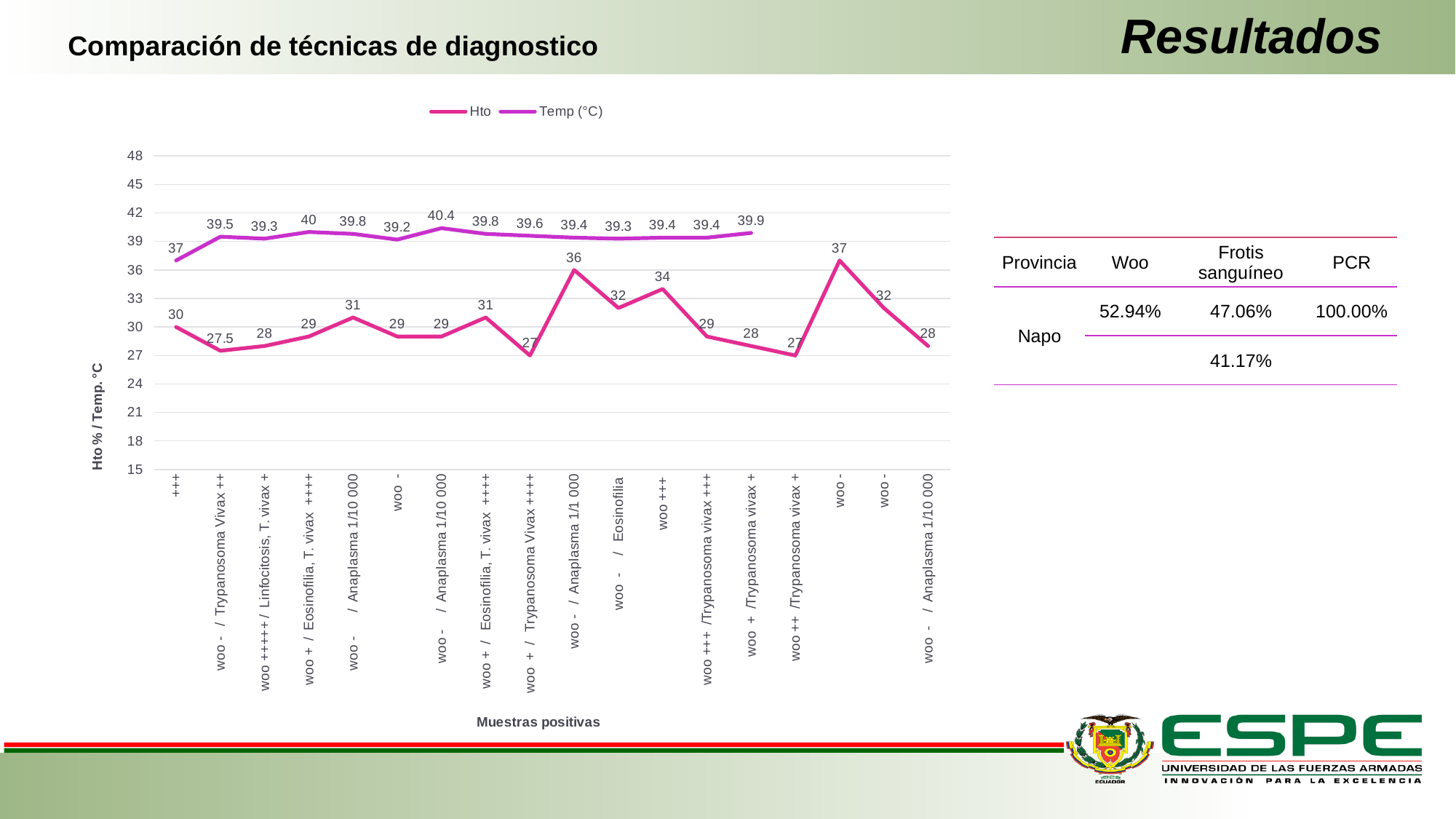
What is the Hto value for the category "woo +++"? 34 What kind of chart is shown on the slide? line chart What is the Hto value for the category "woo - / Anaplasma 1/1 000"? 36 What is the Temp (°C) value for the category "woo + /Trypanosoma vivax +"? 39.9 What is the highest Hto value plotted on the chart? 37 What is the difference between the Hto value for "woo +++" and the Hto value for "woo +++ /Trypanosoma vivax +++"? 5 Which has the larger Hto value: "woo - / Eosinofilia" or "woo +++"? woo +++ Which category has the lowest Temp (°C) value? +++ What is the Temp (°C) value for the first category, "+++"? 37 How many series does the chart legend list? 2 What is the highest Temp (°C) value plotted on the chart? 40.4 What is the Hto value for the category "woo - / Trypanosoma Vivax ++"? 27.5